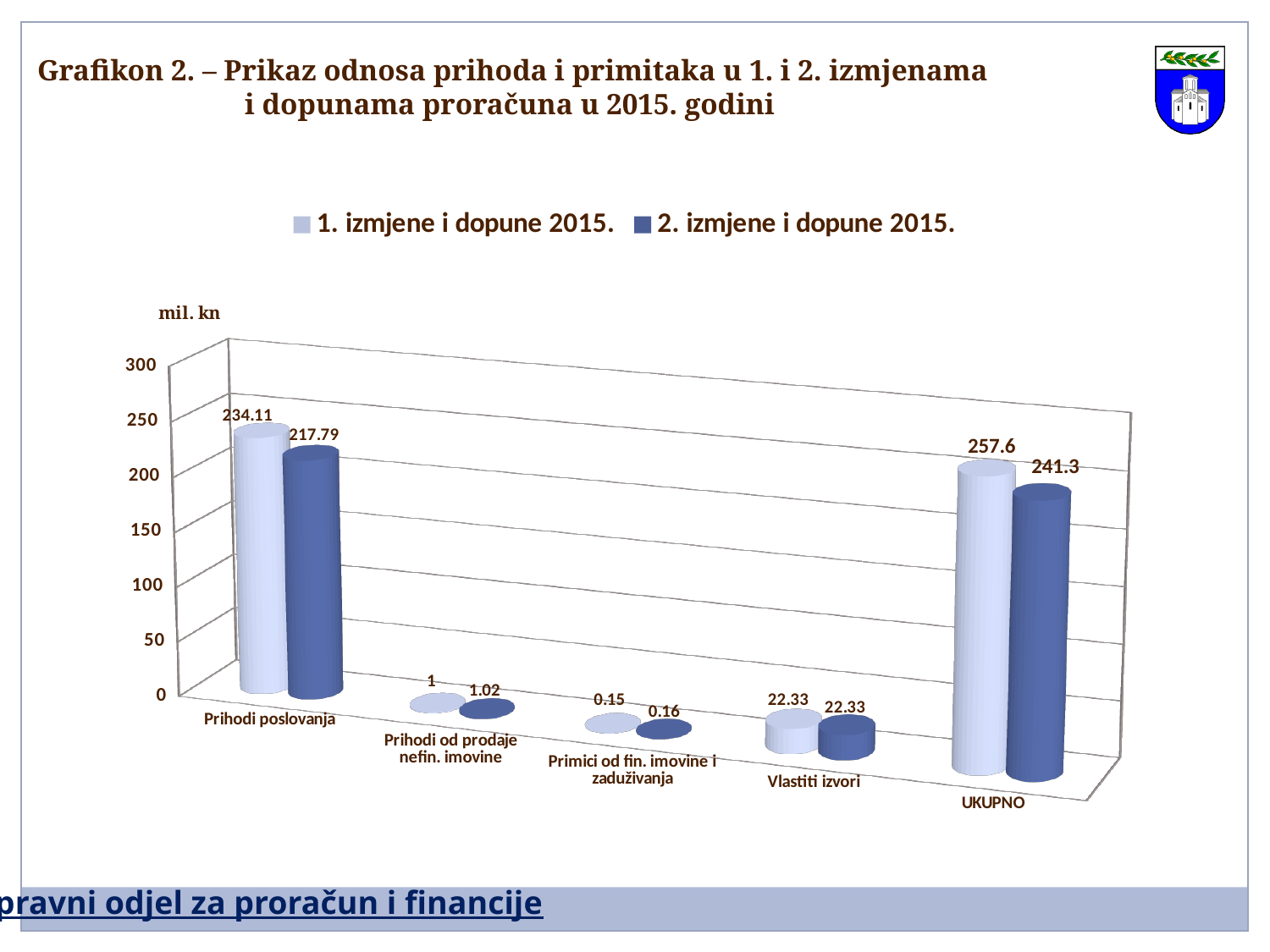
What is the value for Vlastiti izvori in the series 1. izmjene i dopune 2015.? 22.33 What is the difference between the 1. izmjene i dopune 2015. and 2. izmjene i dopune 2015. values for Prihodi poslovanja? 16.32 How many categories are shown on the x axis? 5 How many series does the legend list? 2 What is the value for UKUPNO in the series 2. izmjene i dopune 2015.? 241.3 What kind of chart is shown on the slide? Bar chart What is the value for Primici od fin. imovine i zaduživanja in the series 2. izmjene i dopune 2015.? 0.16 What is the difference between the 1. izmjene i dopune 2015. and 2. izmjene i dopune 2015. values for UKUPNO? 16.3 Which category has the lowest value in the series 2. izmjene i dopune 2015.? Primici od fin. imovine i zaduživanja For Prihodi poslovanja, which series has the larger value: 1. izmjene i dopune 2015. or 2. izmjene i dopune 2015.? 1. izmjene i dopune 2015. What is the value for Prihodi poslovanja in the series 1. izmjene i dopune 2015.? 234.11 Which category has the highest value in the series 1. izmjene i dopune 2015.? UKUPNO